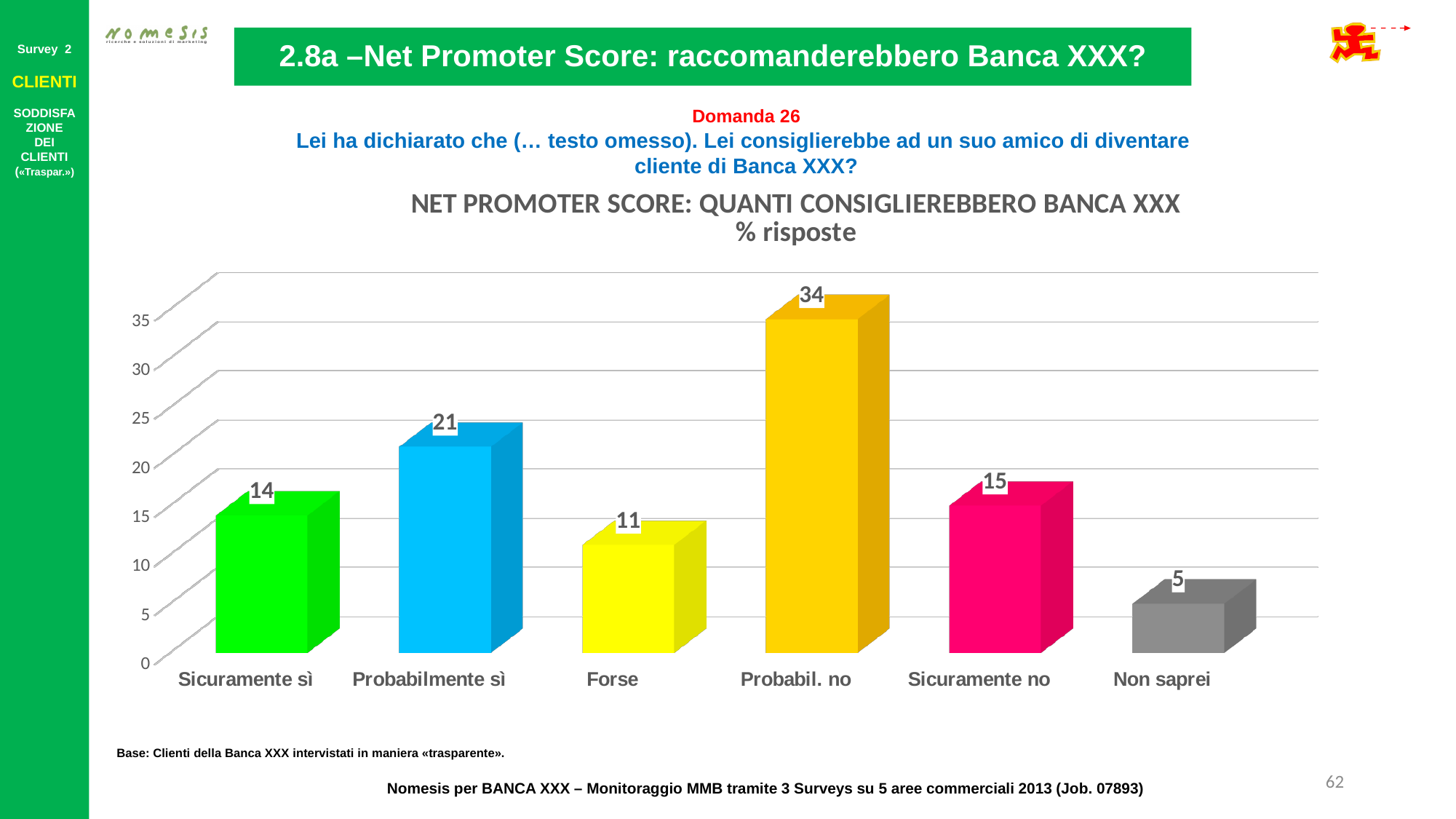
What is the difference between the values for "Probabil. no" and "Probabilmente sì"? 13 What is the value for "Sicuramente sì"? 14 What is the difference between the values for "Sicuramente sì" and "Forse"? 3 Which category has the highest value? Probabil. no Which category has the lowest value? Non saprei How many categories are shown on the x axis? 6 What is the value for "Probabil. no"? 34 Is the value for "Forse" greater or less than 15? less What kind of chart is shown on the slide? bar chart Which is larger, the value for "Sicuramente no" or the value for "Sicuramente sì"? Sicuramente no What colour is the bar for "Probabil. no"? yellow-orange What is the value for "Non saprei"? 5